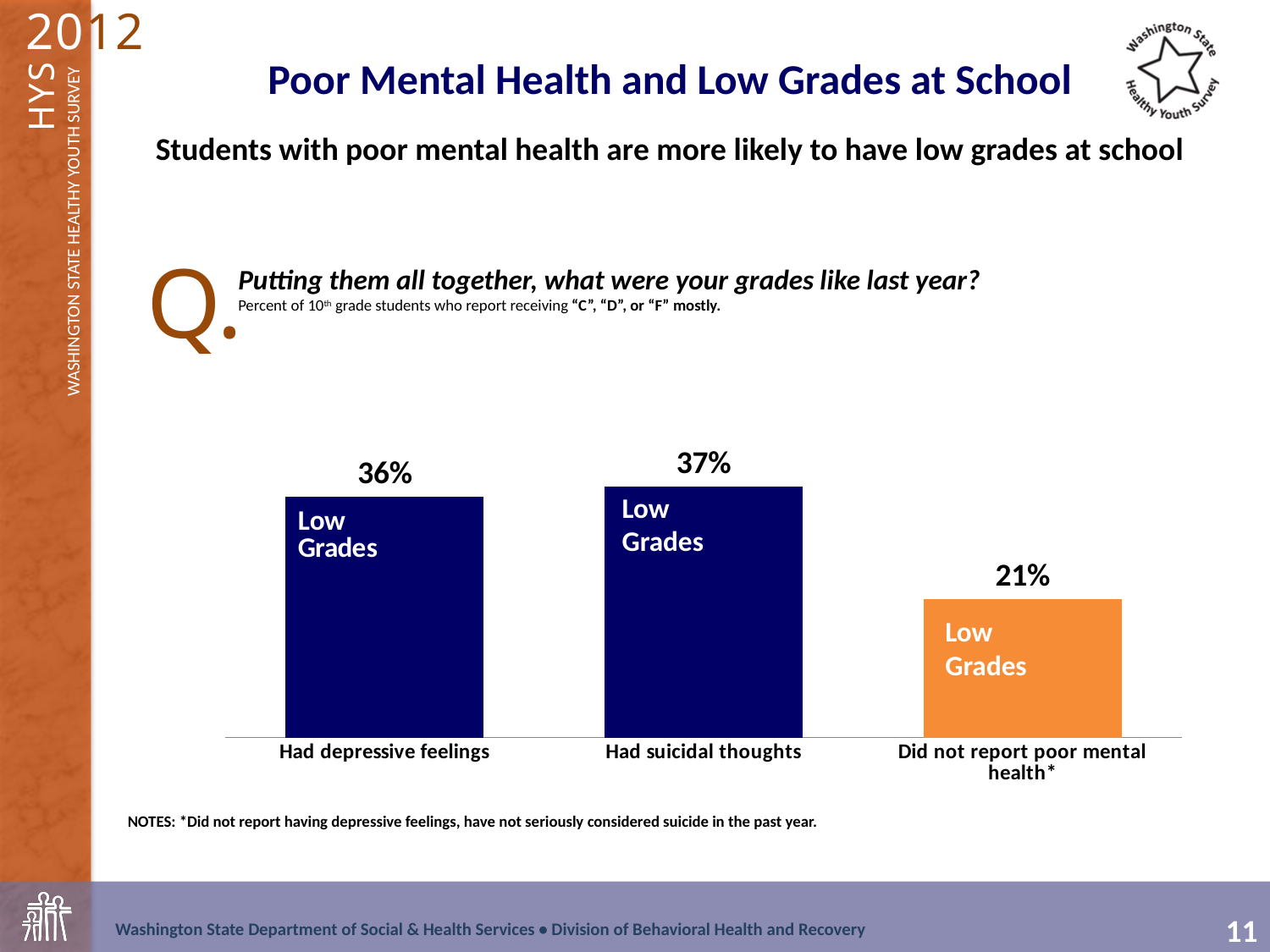
Which category has the highest percentage of students with low grades? Had suicidal thoughts What kind of chart is shown on the slide? Bar chart What percent of students who did not report poor mental health reported low grades? 21% How many categories are shown on the x axis of the chart? 3 What is the difference in percentage points between students who had suicidal thoughts and those who did not report poor mental health? 16 What colour is the bar for 'Did not report poor mental health*'? Orange Which is larger: the value for 'Had depressive feelings' or the value for 'Did not report poor mental health*'? Had depressive feelings What label is printed inside each bar of the chart? Low Grades What percent of students who had suicidal thoughts reported low grades? 37% Which category has the lowest percentage of students with low grades? Did not report poor mental health* What percent of students who had depressive feelings reported low grades? 36% What is the difference in percentage points between students who had depressive feelings and those who did not report poor mental health? 15